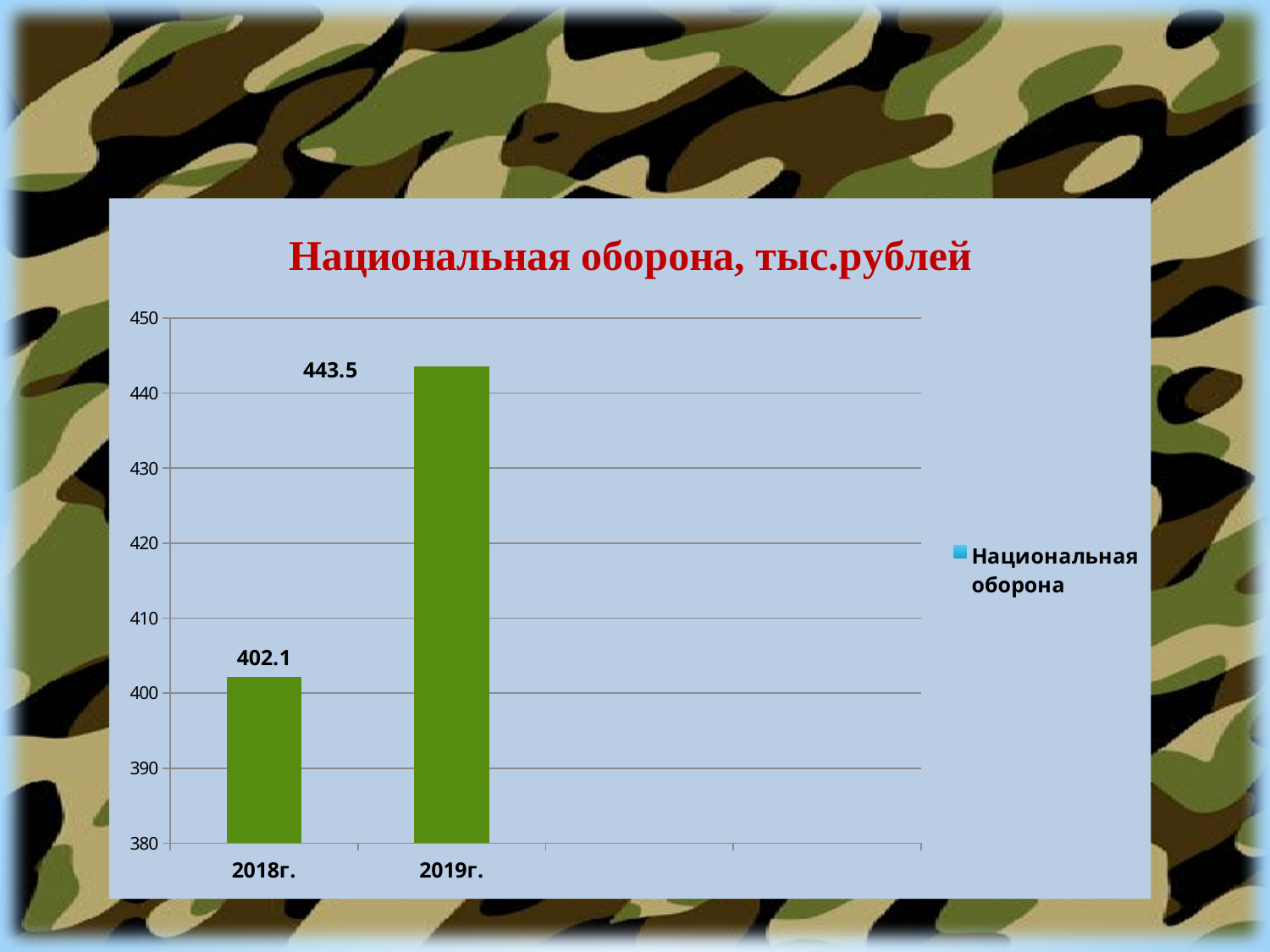
What kind of chart is shown? bar chart Do the values rise or fall from 2018г. to 2019г.? rise Which is larger, the value for 2018г. or the value for 2019г.? 2019г. Which year has the lowest value? 2018г. What is the value for 2019г.? 443.5 How many categories are shown on the x axis? 2 What is the difference between the values for 2019г. and 2018г.? 41.4 How many series does the legend list? 1 What is the value for 2018г.? 402.1 Is the value for 2019г. greater or less than 440? greater Which year has the highest value? 2019г. Is the value for 2018г. greater or less than 410? less